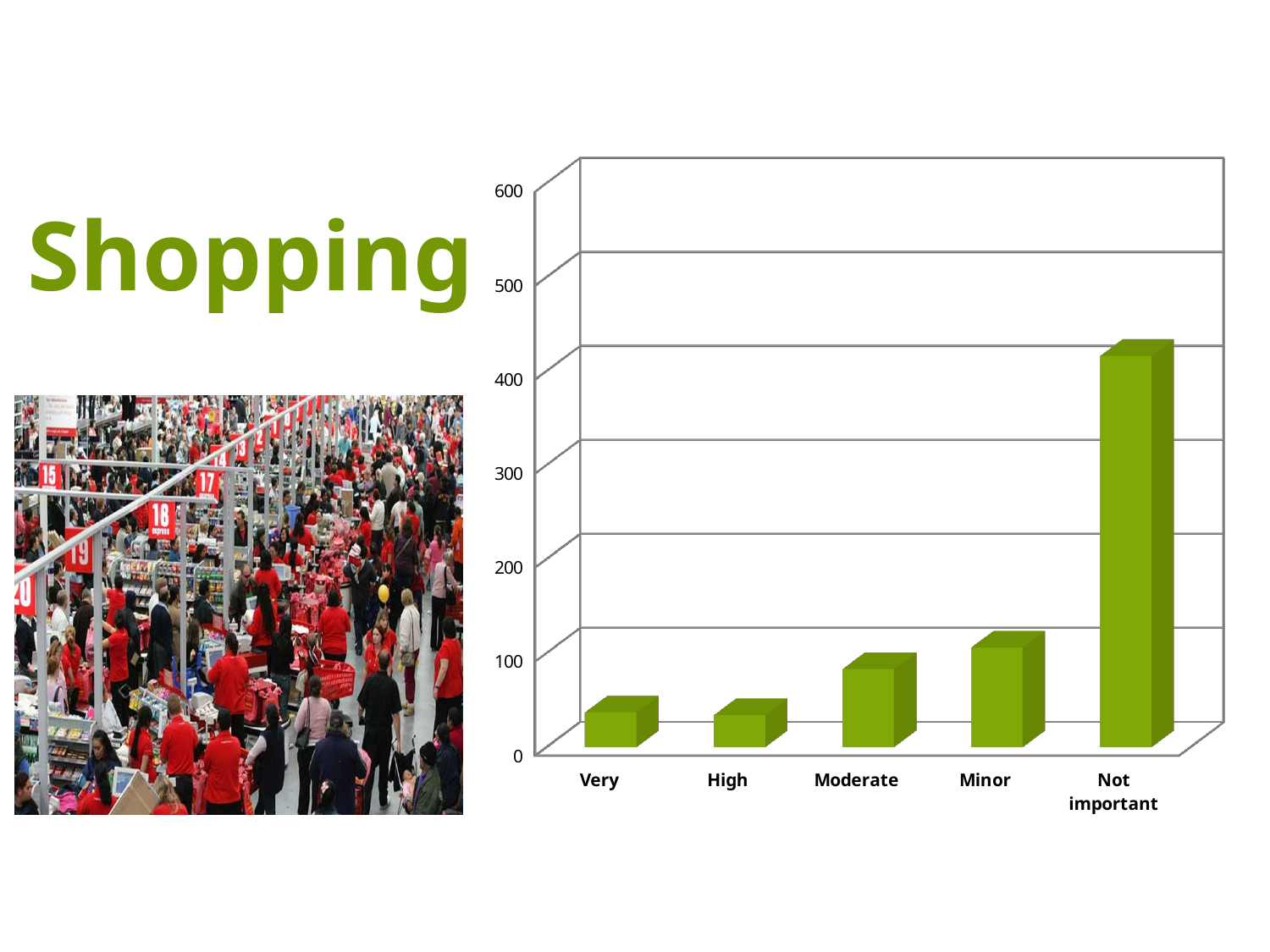
Which is larger, the value for Not important or the value for Minor? Not important Is the value for High greater or less than 100? less Which category has the highest value in the chart? Not important Is the value for Not important greater or less than 300? greater Is the value for Very greater or less than 100? less What colour are the bars in the chart? green How many categories are shown on the x axis of the chart? 5 What is the label of the last category on the x axis? Not important What kind of chart is shown on the slide? bar chart Which is larger, the value for Moderate or the value for Very? Moderate